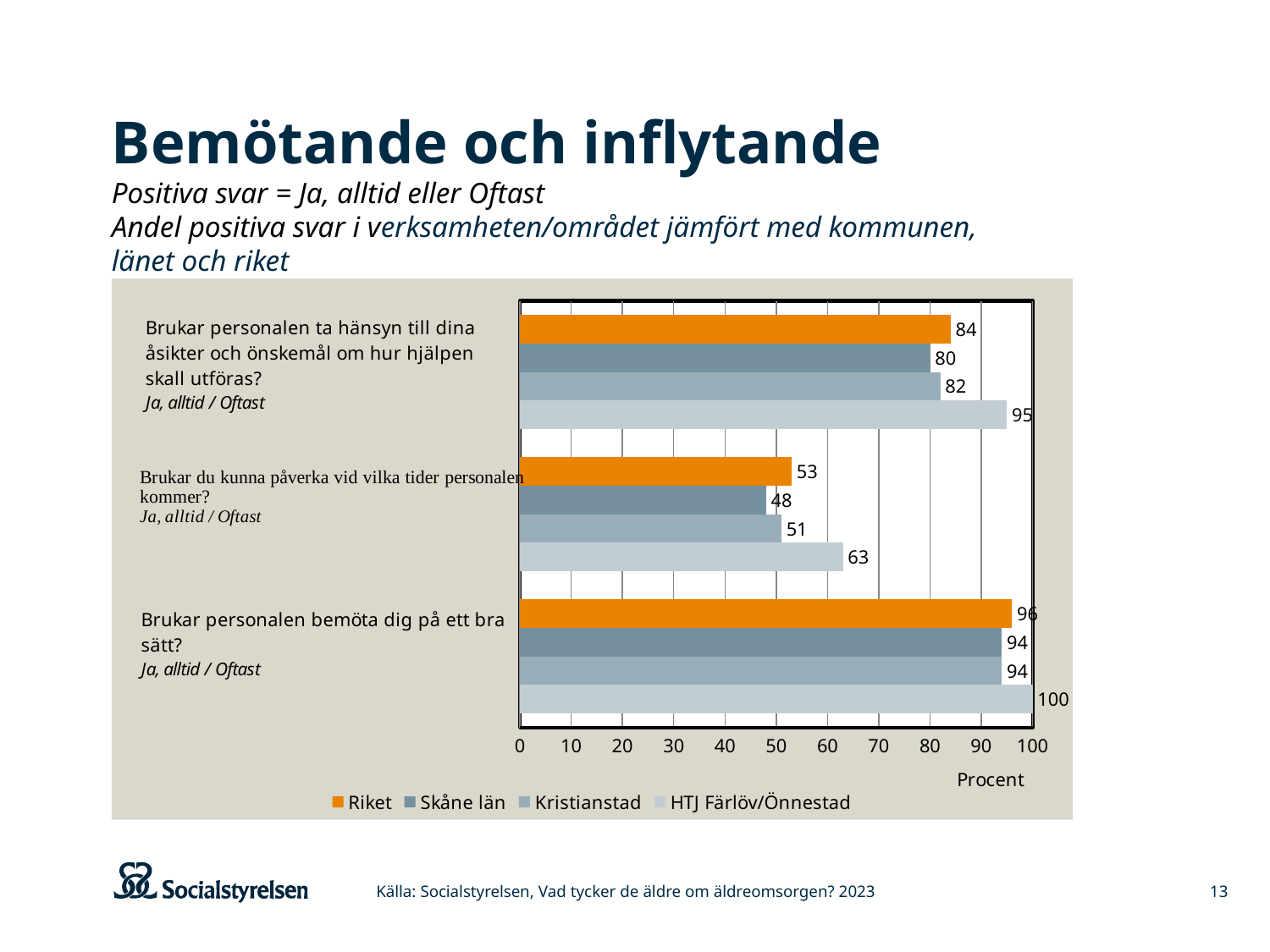
What kind of chart is shown on the slide? bar chart For 'Brukar personalen ta hänsyn till dina åsikter och önskemål om hur hjälpen skall utföras?', which is larger, Riket or Kristianstad? Riket Which series is shown in orange in the legend? Riket What is the value for Riket for 'Brukar du kunna påverka vid vilka tider personalen kommer?' 53 What is the value for HTJ Färlöv/Önnestad for 'Brukar personalen ta hänsyn till dina åsikter och önskemål om hur hjälpen skall utföras?' 95 What label is shown on the horizontal axis of the chart? Procent How many question categories are plotted on the chart? 3 What is the difference between HTJ Färlöv/Önnestad and Riket for 'Brukar du kunna påverka vid vilka tider personalen kommer?' 10 How many series does the legend list? 4 Which series has the highest value for 'Brukar personalen bemöta dig på ett bra sätt?' HTJ Färlöv/Önnestad Which series has the lowest value for 'Brukar du kunna påverka vid vilka tider personalen kommer?' Skåne län What is the value for Skåne län for 'Brukar personalen bemöta dig på ett bra sätt?' 94